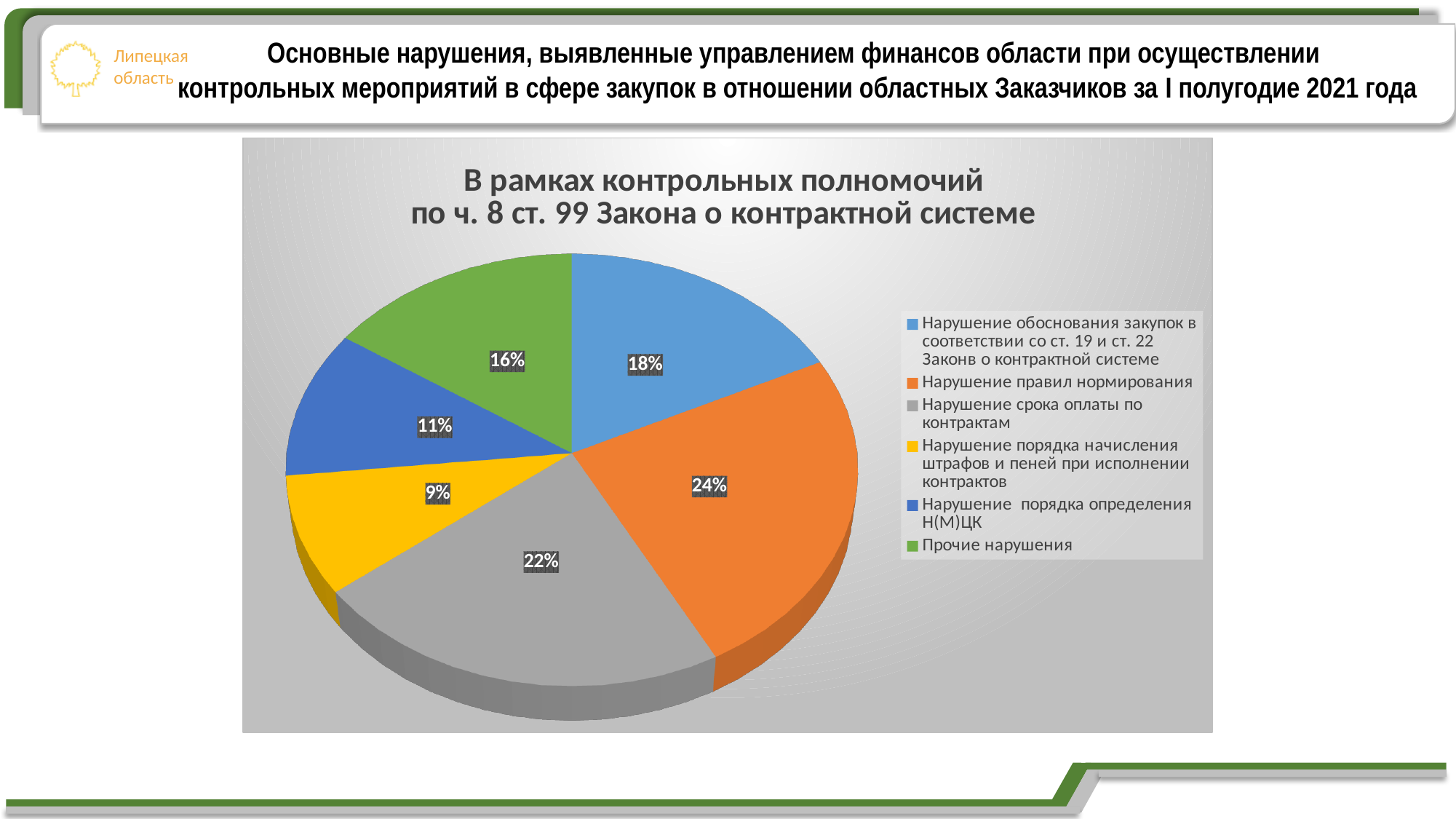
What is the title of the chart? В рамках контрольных полномочий по ч. 8 ст. 99 Закона о контрактной системе Which category has the largest slice of the pie? Нарушение правил нормирования How many slices does the pie chart have? 6 Which is larger: the share for "Нарушение обоснования закупок в соответствии со ст. 19 и ст. 22 Законв о контрактной системе" or the share for "Прочие нарушения"? Нарушение обоснования закупок в соответствии со ст. 19 и ст. 22 Законв о контрактной системе What share of the pie does "Нарушение правил нормирования" have? 24% What colour is the slice for "Нарушение срока оплаты по контрактам"? Grey What kind of chart is shown on the slide? Pie chart What is the value shown for "Нарушение порядка определения Н(М)ЦК"? 11% What is the difference between the share for "Нарушение правил нормирования" and the share for "Нарушение порядка начисления штрафов и пеней при исполнении контрактов"? 15% What share of the pie does "Нарушение срока оплаты по контрактам" have? 22% Which category has the smallest slice of the pie? Нарушение порядка начисления штрафов и пеней при исполнении контрактов What is the value shown for "Прочие нарушения"? 16%